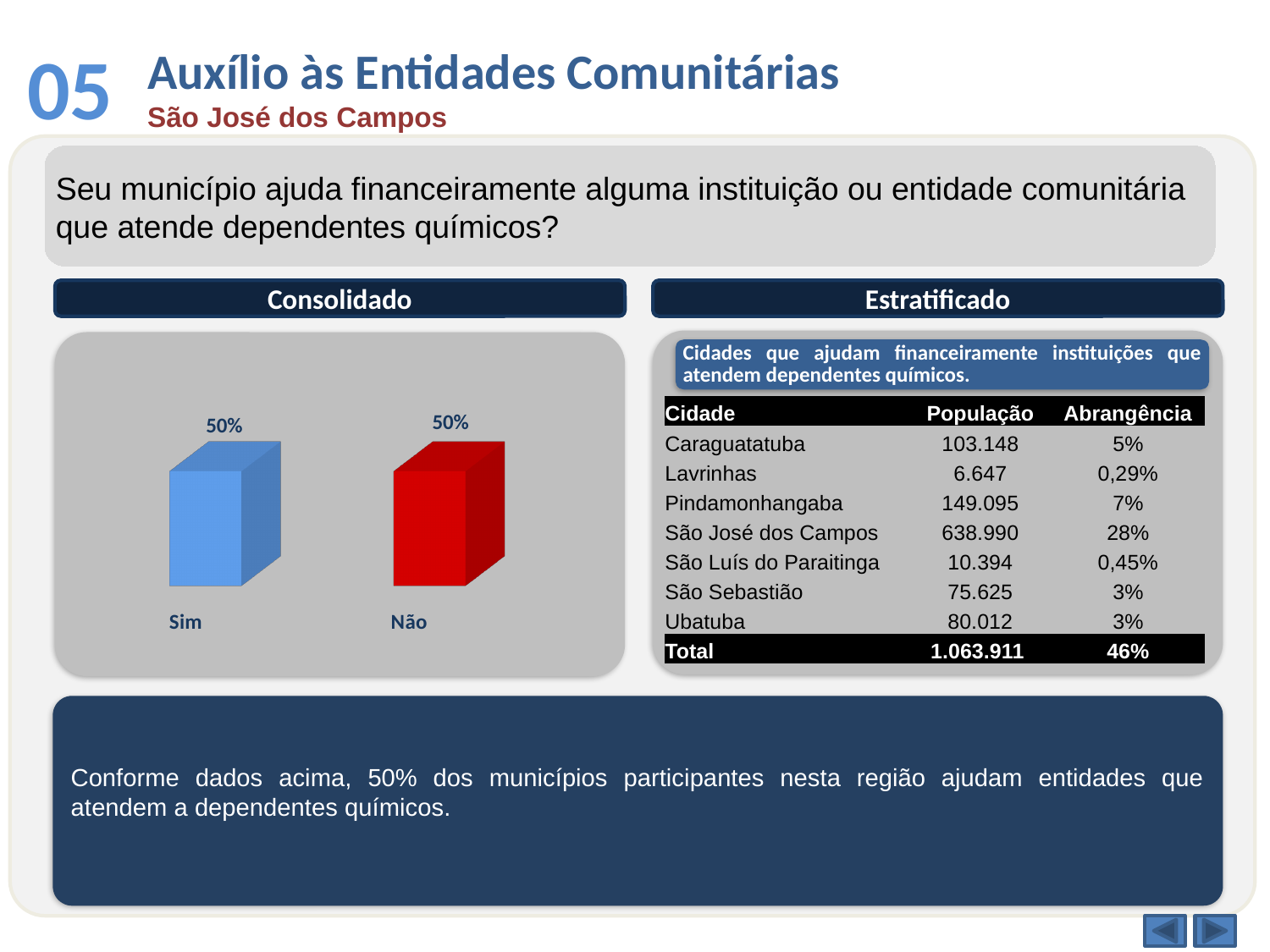
What are the category labels on the x axis of the Consolidado chart? Sim, Não What colour is the Sim bar in the Consolidado chart? blue What is the difference between the values for Sim and Não in the Consolidado chart? 0% What is the value for Sim in the Consolidado chart? 50% What is the value for Não in the Consolidado chart? 50% What colour is the Não bar in the Consolidado chart? red How many categories are shown in the Consolidado chart? 2 What kind of chart is shown under Consolidado? bar chart